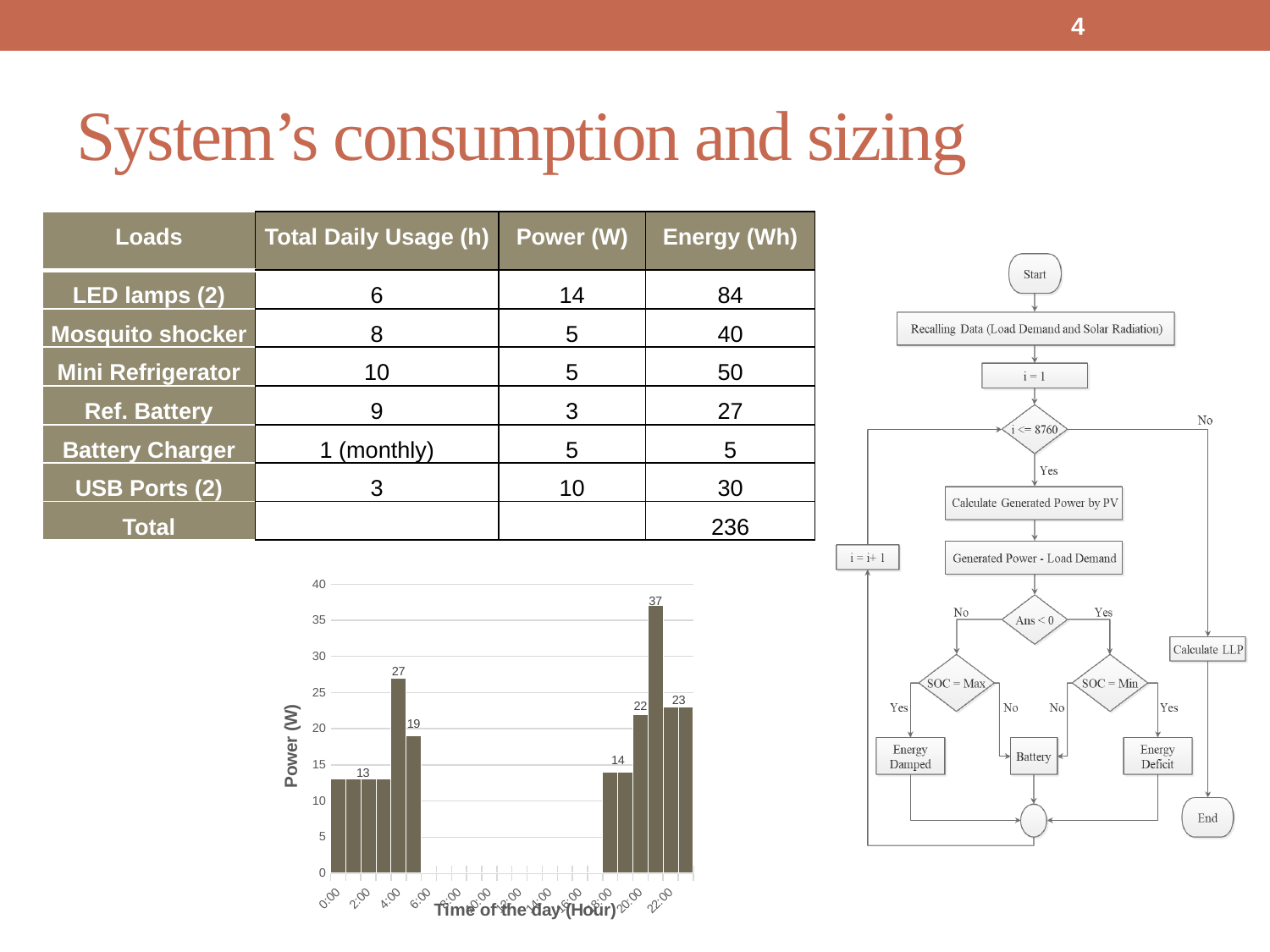
What is the power value at 4:00 in the bar chart? 27 Is the power value at 4:00 greater or less than 25? greater What type of chart is shown at the bottom left of the slide? bar chart How many bars are plotted in the bar chart? 12 What is the title of the x-axis of the bar chart? Time of the day (Hour) What is the difference between the highest bar (37) and the bar at 4:00 (27)? 10 What is the lowest power value shown in the bar chart? 13 Which is larger in the bar chart: the bar labelled 27 or the bar labelled 19? 27 What is the highest power value shown in the bar chart? 37 What is the power value at 0:00 in the bar chart? 13 Is the power value at 0:00 greater or less than 15? less What is the title of the y-axis of the bar chart? Power (W)